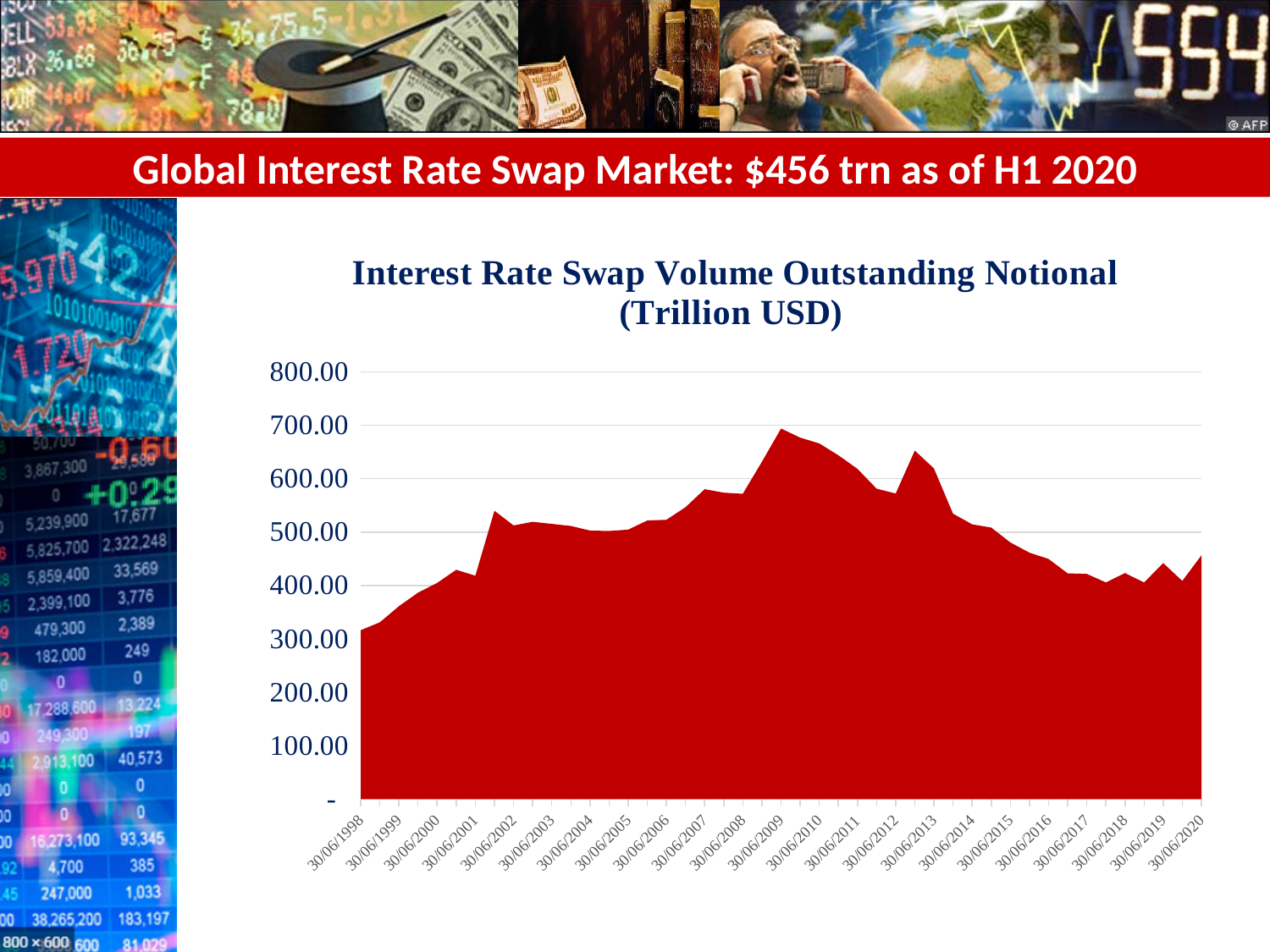
Is the value for 30/06/2007 greater or less than 500.00? greater Is the value for 30/06/2009 greater or less than 600.00? greater Do the values rise or fall between 30/06/2013 and 30/06/2016? fall Which is larger, the value for 30/06/2009 or the value for 30/06/2013? 30/06/2009 What kind of chart is shown on the slide? Area chart How many dates are labelled along the x axis of the chart? 23 Is the value for 30/06/2020 greater or less than 500.00? less At which date does the chart reach its highest value? 30/06/2009 At which date does the chart show its lowest value? 30/06/1998 What is the title of the chart? Interest Rate Swap Volume Outstanding Notional (Trillion USD) Do the values rise or fall between 30/06/1998 and 30/06/2001? rise